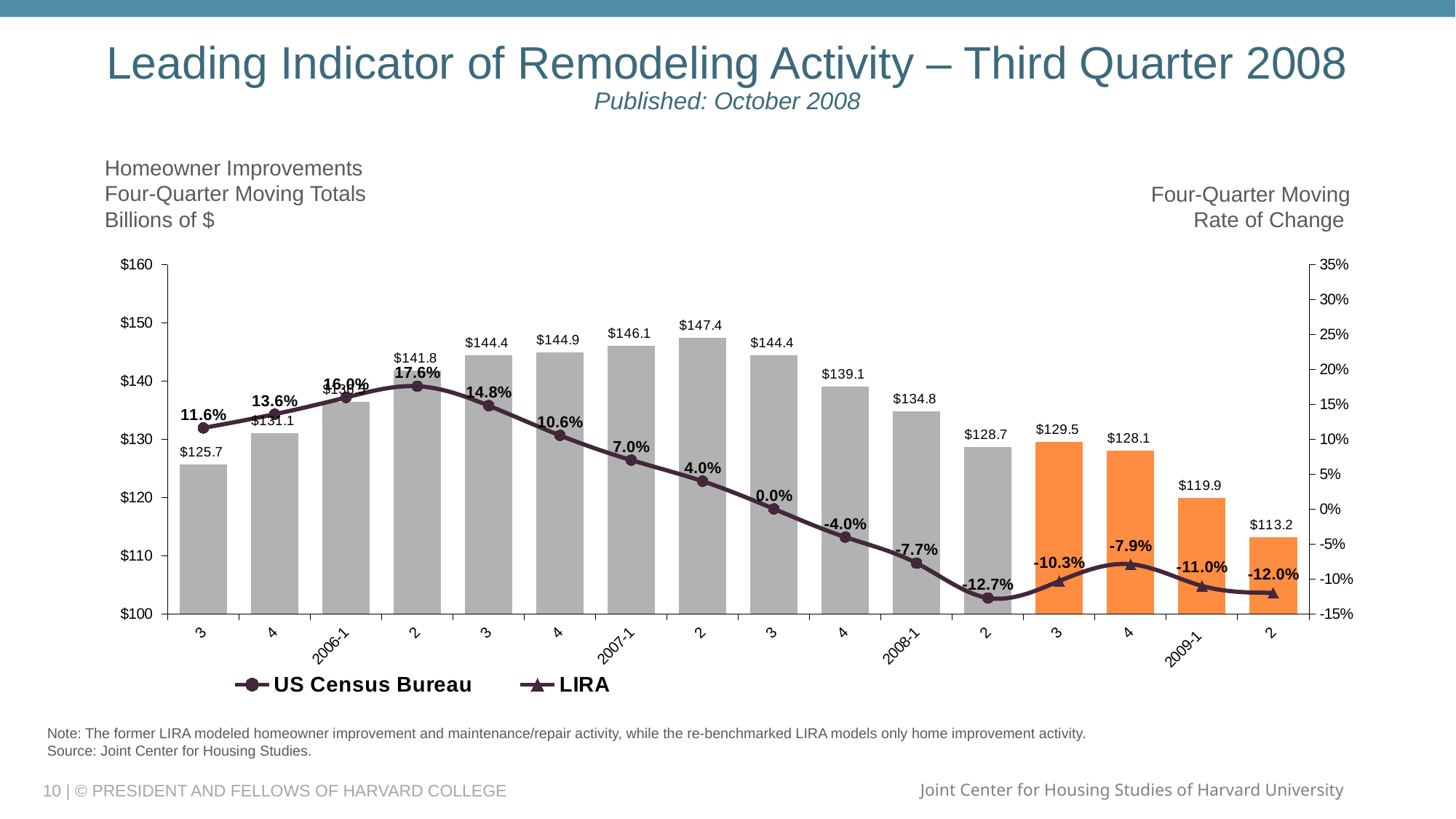
What is the highest four-quarter moving rate of change shown on the line? 17.6% Which quarter has the highest four-quarter moving total? 2007-2 How many quarters (bars) are plotted on the chart? 16 What are the two series named in the legend? US Census Bureau and LIRA How many series does the legend list? 2 Do the four-quarter moving totals rise or fall from 2007-2 to 2009-2? fall What is the four-quarter moving rate of change shown for 2008-2? -12.7% What is the four-quarter moving total for 2007-1? $146.1 What is the four-quarter moving total for 2009-1? $119.9 Which is larger, the four-quarter moving total for 2008-3 or for 2008-4? 2008-3 Which quarter has the lowest four-quarter moving total? 2009-2 What is the difference between the four-quarter moving totals for 2007-2 and 2009-2? $34.2